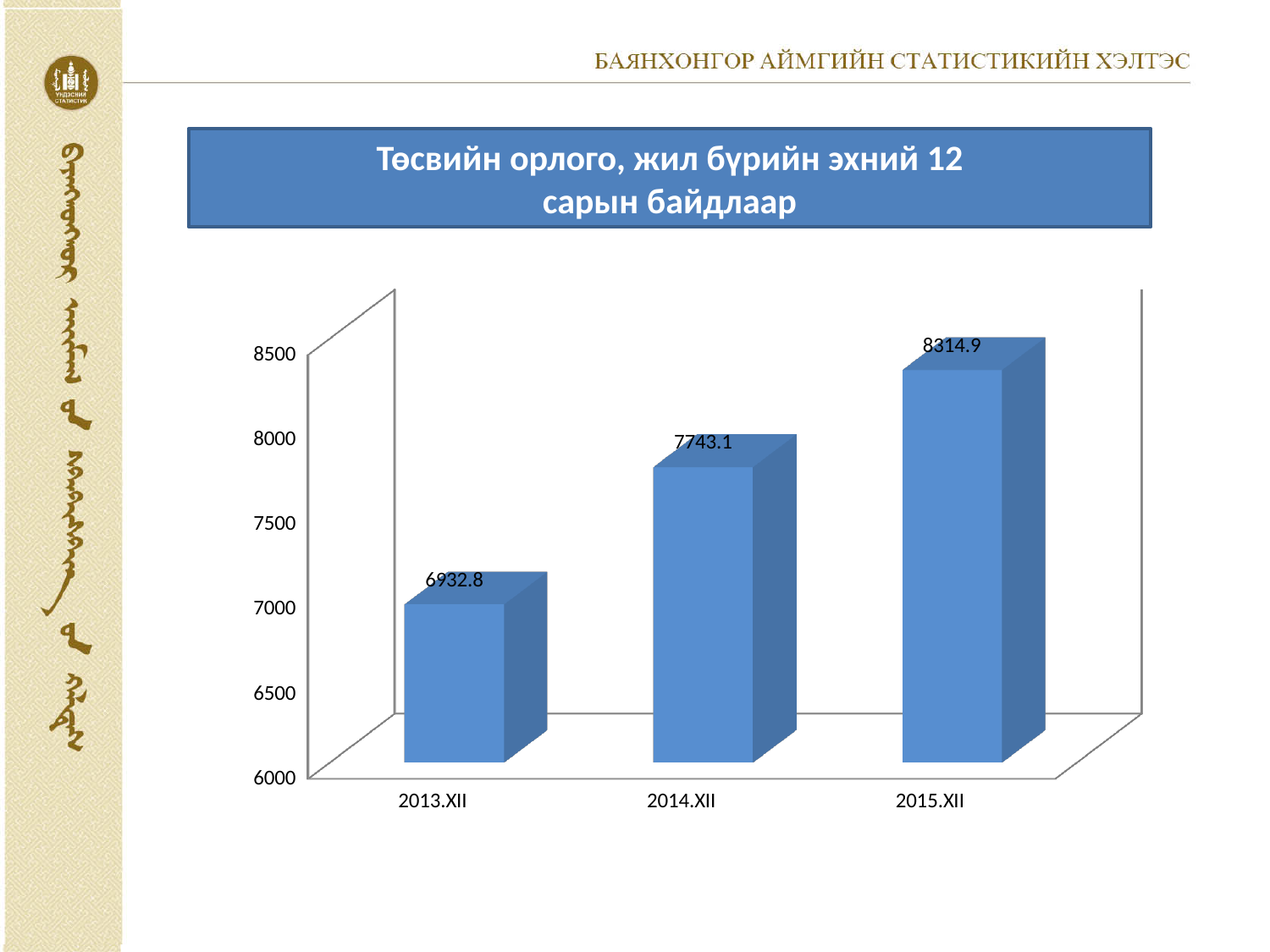
What is the value for 2013.XII? 6932.8 Is the value for 2015.XII greater or less than 8000? greater Which category has the lowest value? 2013.XII How many categories are shown on the x axis? 3 Which is larger, the value for 2013.XII or the value for 2014.XII? 2014.XII Do the values rise or fall from 2013.XII to 2015.XII? rise Which category has the highest value? 2015.XII What is the difference between the values for 2014.XII and 2013.XII? 810.3 What is the value for 2014.XII? 7743.1 What kind of chart is shown on the slide? bar chart What is the difference between the values for 2015.XII and 2014.XII? 571.8 What is the value for 2015.XII? 8314.9